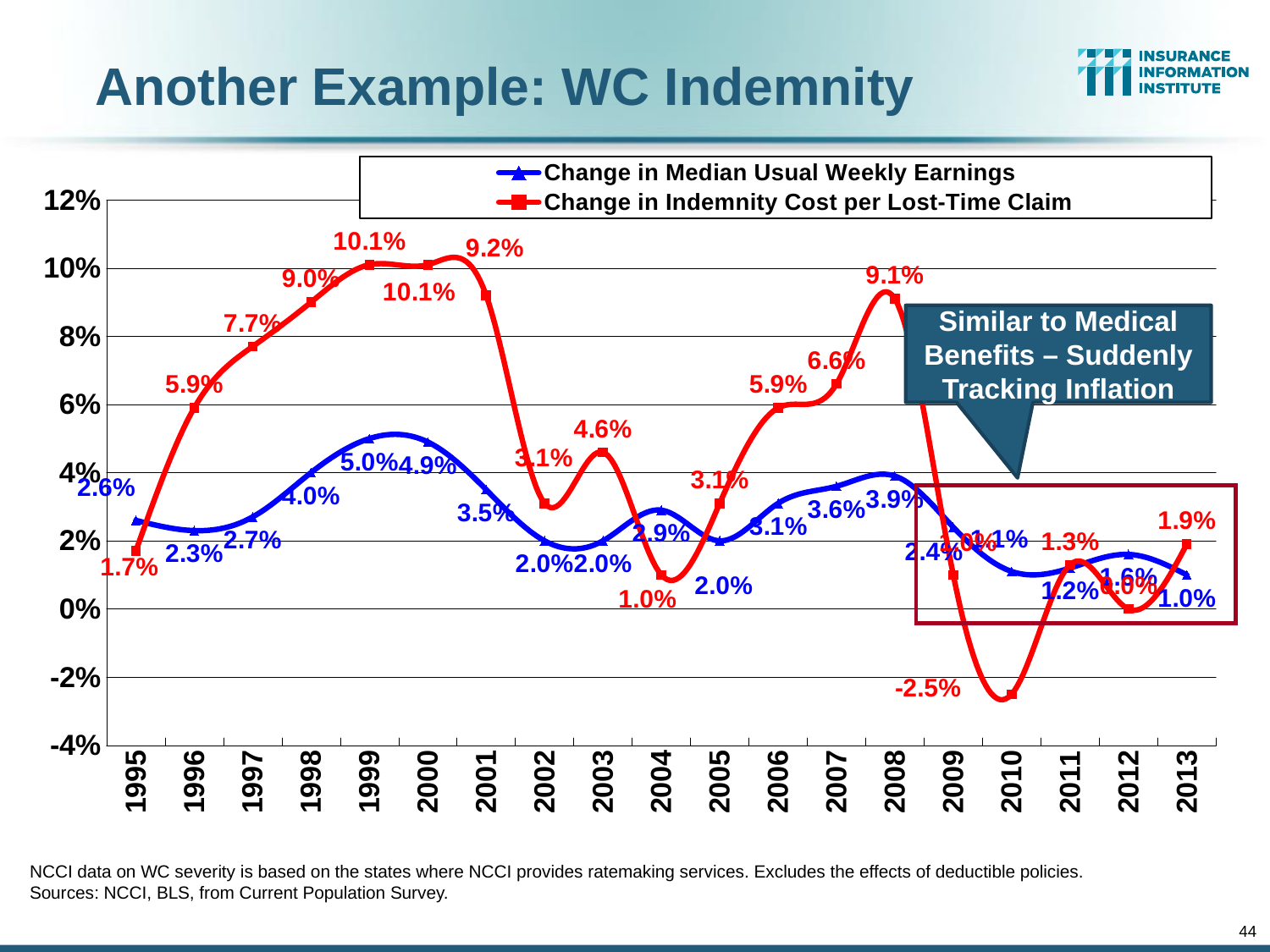
How many years are plotted along the x axis? 19 Does the Change in Indemnity Cost per Lost-Time Claim rise or fall from 1995 to 1999? Rise In 2004, which is larger: the Change in Median Usual Weekly Earnings or the Change in Indemnity Cost per Lost-Time Claim? Change in Median Usual Weekly Earnings What is the Change in Median Usual Weekly Earnings in 2008? 3.9% How many series does the legend list? 2 Is the Change in Indemnity Cost per Lost-Time Claim in 2006 greater or less than 4%? greater Which colour is used for the Change in Median Usual Weekly Earnings series? Blue In which year is the Change in Indemnity Cost per Lost-Time Claim lowest? 2010 What kind of chart is shown on the slide? Line chart What is the Change in Indemnity Cost per Lost-Time Claim in 2010? -2.5% What is the difference between the Change in Indemnity Cost per Lost-Time Claim and the Change in Median Usual Weekly Earnings in 2008? 5.2 percentage points What is the Change in Indemnity Cost per Lost-Time Claim in 1999? 10.1%